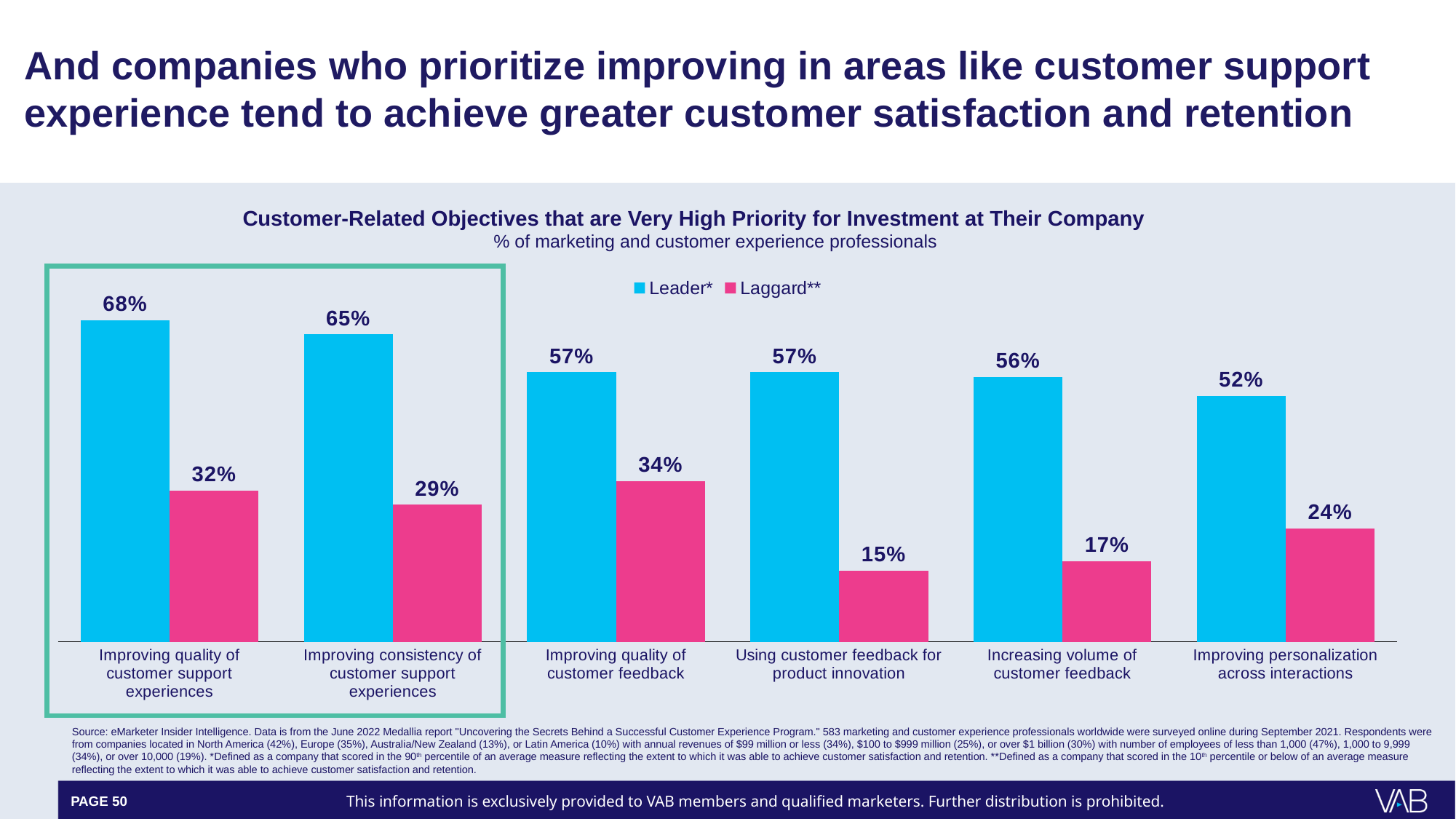
Which is larger: the Laggard** value for Improving quality of customer feedback or the Laggard** value for Improving quality of customer support experiences? Improving quality of customer feedback What is the Laggard** value for Using customer feedback for product innovation? 15% What is the Leader* value for Improving quality of customer support experiences? 68% What kind of chart is shown on the slide? Bar chart What is the Laggard** value for Improving personalization across interactions? 24% How many categories are shown on the x axis? 6 What is the difference between the Leader* and Laggard** values for Improving consistency of customer support experiences? 36 percentage points Do the Leader* values rise or fall from left to right across the categories? Fall How many series does the legend list? 2 What is the title of the chart? Customer-Related Objectives that are Very High Priority for Investment at Their Company Which category has the highest Leader* value? Improving quality of customer support experiences Which category has the lowest Laggard** value? Using customer feedback for product innovation